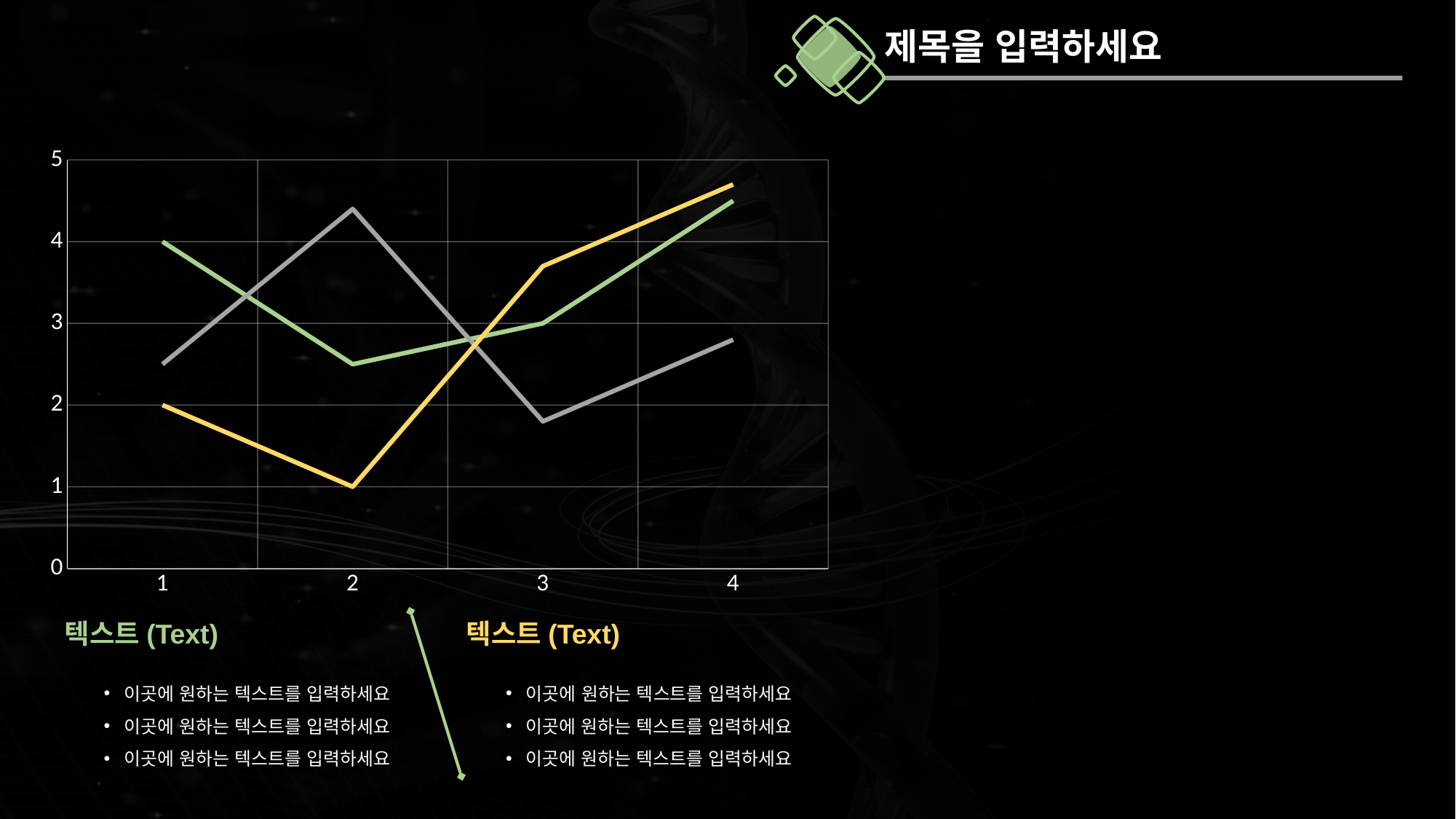
How many lines are plotted on the chart? 3 Is the value of the gray line at x = 3 greater or less than 2? less What is the value of the green line at x = 3? 3 What is the value of the green line at x = 1? 4 Which line has the lowest value at x = 2? the yellow line Does the yellow line rise or fall from x = 2 to x = 4? rise What kind of chart is shown on the slide? line chart Which line has the highest value at x = 4? the yellow line Is the value of the gray line at x = 2 greater or less than 4? greater What is the value of the yellow line at x = 1? 2 How many points are marked on the x axis of the chart? 4 What is the value of the yellow line at x = 2? 1